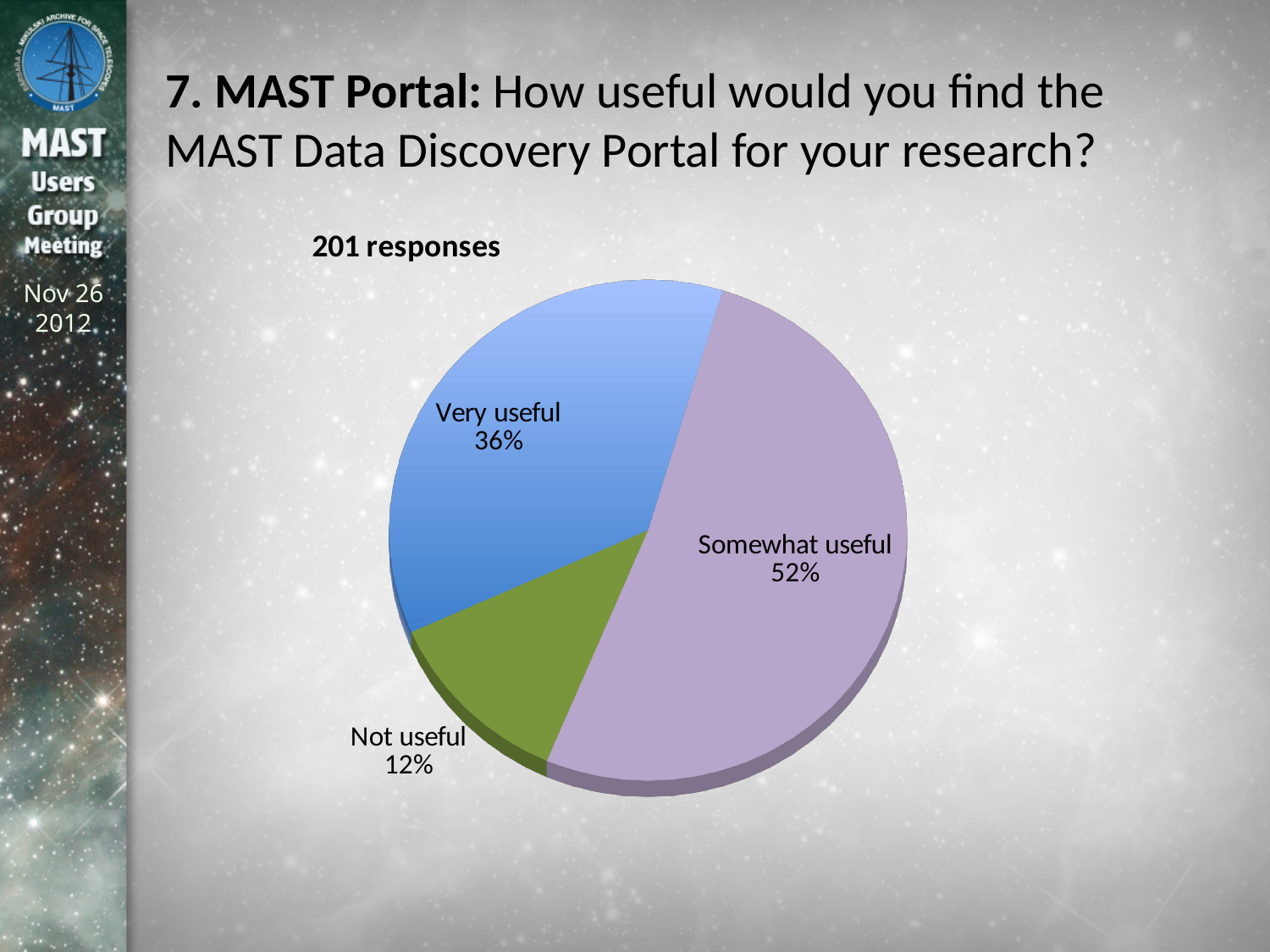
What percentage of respondents said the portal would be somewhat useful? 52% What is the difference in percentage points between the 'Somewhat useful' and 'Very useful' slices? 16 How many responses does the chart represent? 201 responses What colour is the 'Not useful' slice? green What kind of chart is shown on the slide? pie chart What percentage of respondents said the MAST Data Discovery Portal would be very useful? 36% How many slices does the pie chart have? 3 Which response category has the smallest share of the pie? Not useful Which slice is larger, 'Very useful' or 'Not useful'? Very useful Which response category has the largest share of the pie? Somewhat useful What is the combined share of the 'Very useful' and 'Somewhat useful' slices? 88% What percentage of respondents said the portal would be not useful? 12%